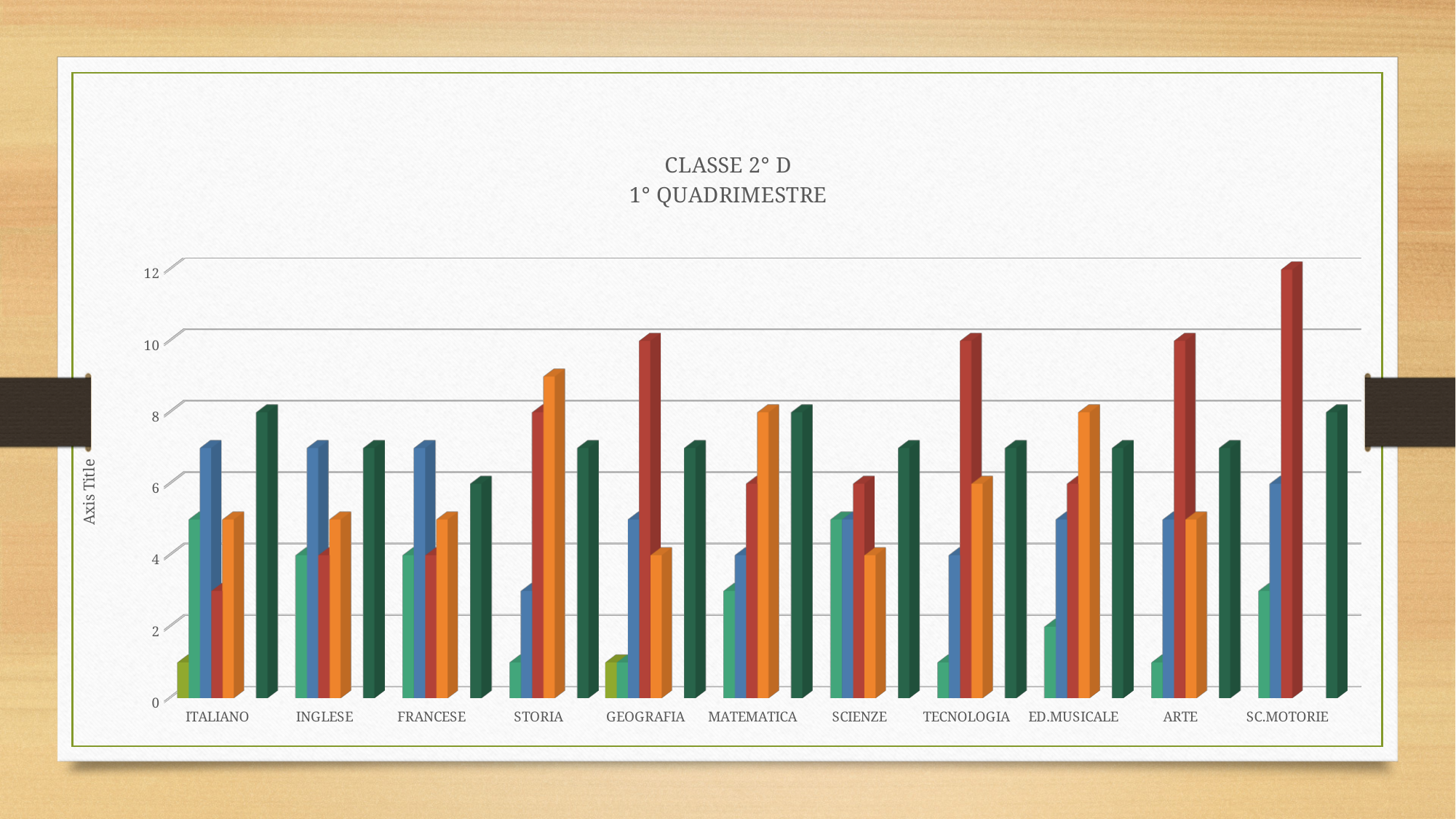
What label is shown on the vertical axis? Axis Title Is the teal bar for STORIA greater or less than 2? less What is the title of the chart? CLASSE 2° D 1° QUADRIMESTRE What is the value of the dark green bar for ITALIANO? 8 What type of chart is shown on the slide? Bar chart Which category has the tallest red bar? SC.MOTORIE Which is larger, the orange bar for STORIA or the orange bar for GEOGRAFIA? STORIA What is the difference between the red bar for SC.MOTORIE and the red bar for TECNOLOGIA? 2 What is the value of the red bar for TECNOLOGIA? 10 What is the value of the red bar for SC.MOTORIE? 12 How many subject categories are shown on the x axis? 11 Is the red bar for GEOGRAFIA greater or less than 8? greater